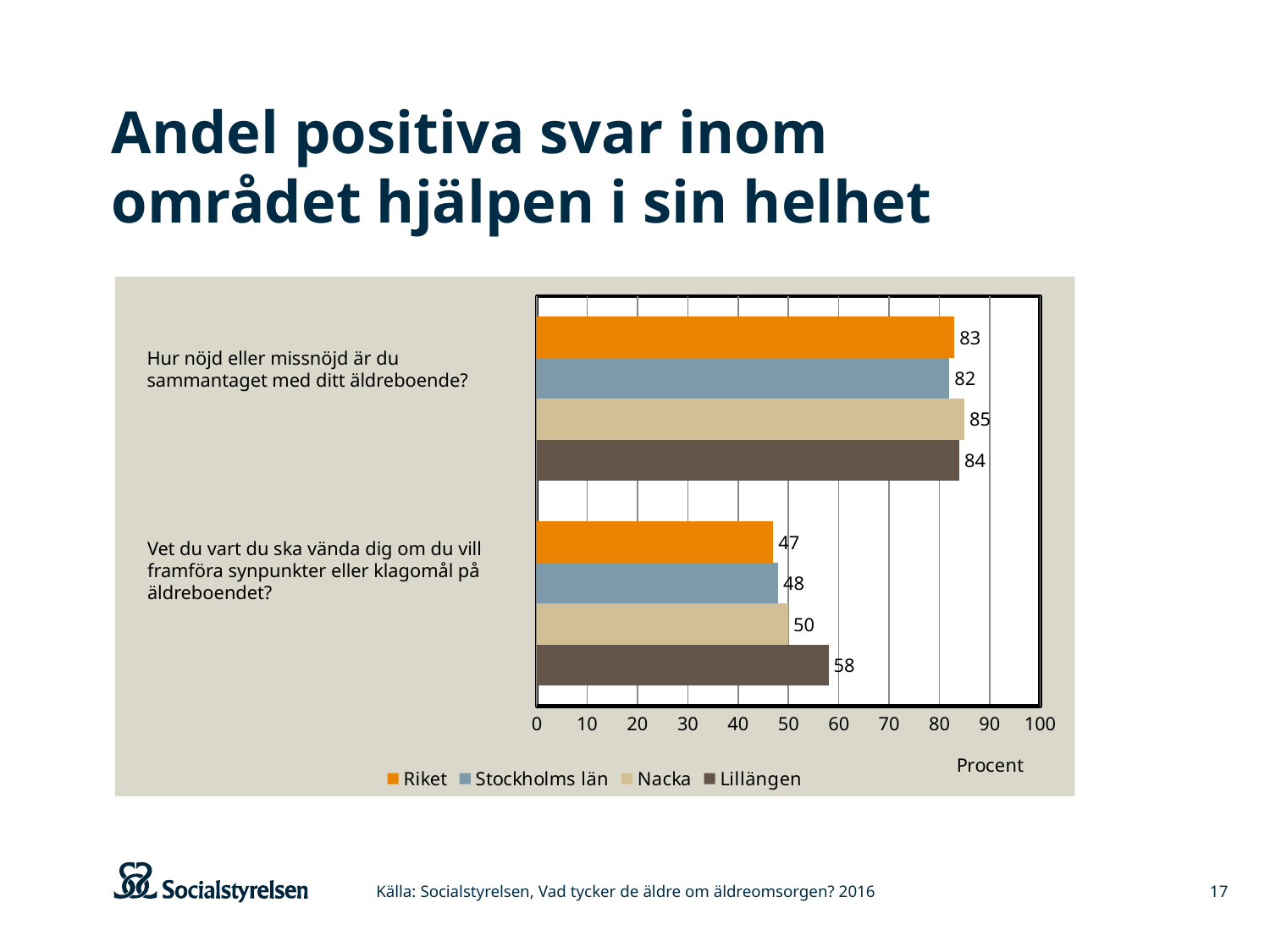
What is the value for Nacka on the question "Hur nöjd eller missnöjd är du sammantaget med ditt äldreboende?"? 85 Which is larger for Nacka: the value for "Hur nöjd eller missnöjd är du sammantaget med ditt äldreboende?" or for "Vet du vart du ska vända dig om du vill framföra synpunkter eller klagomål på äldreboendet?"? Hur nöjd eller missnöjd är du sammantaget med ditt äldreboende? What is the value for Stockholms län on the question "Vet du vart du ska vända dig om du vill framföra synpunkter eller klagomål på äldreboendet?"? 48 What is the value for Lillängen on the question "Vet du vart du ska vända dig om du vill framföra synpunkter eller klagomål på äldreboendet?"? 58 What unit is shown on the x axis of the chart? Procent What is the difference between Lillängen and Riket on the question "Vet du vart du ska vända dig om du vill framföra synpunkter eller klagomål på äldreboendet?"? 11 How many series does the legend list? 4 What kind of chart is shown on the slide? Bar chart Which series has the highest value on the question "Vet du vart du ska vända dig om du vill framföra synpunkter eller klagomål på äldreboendet?"? Lillängen How many questions (categories) are shown on the chart? 2 Which series has the lowest value on the question "Hur nöjd eller missnöjd är du sammantaget med ditt äldreboende?"? Stockholms län What is the value for Riket on the question "Hur nöjd eller missnöjd är du sammantaget med ditt äldreboende?"? 83